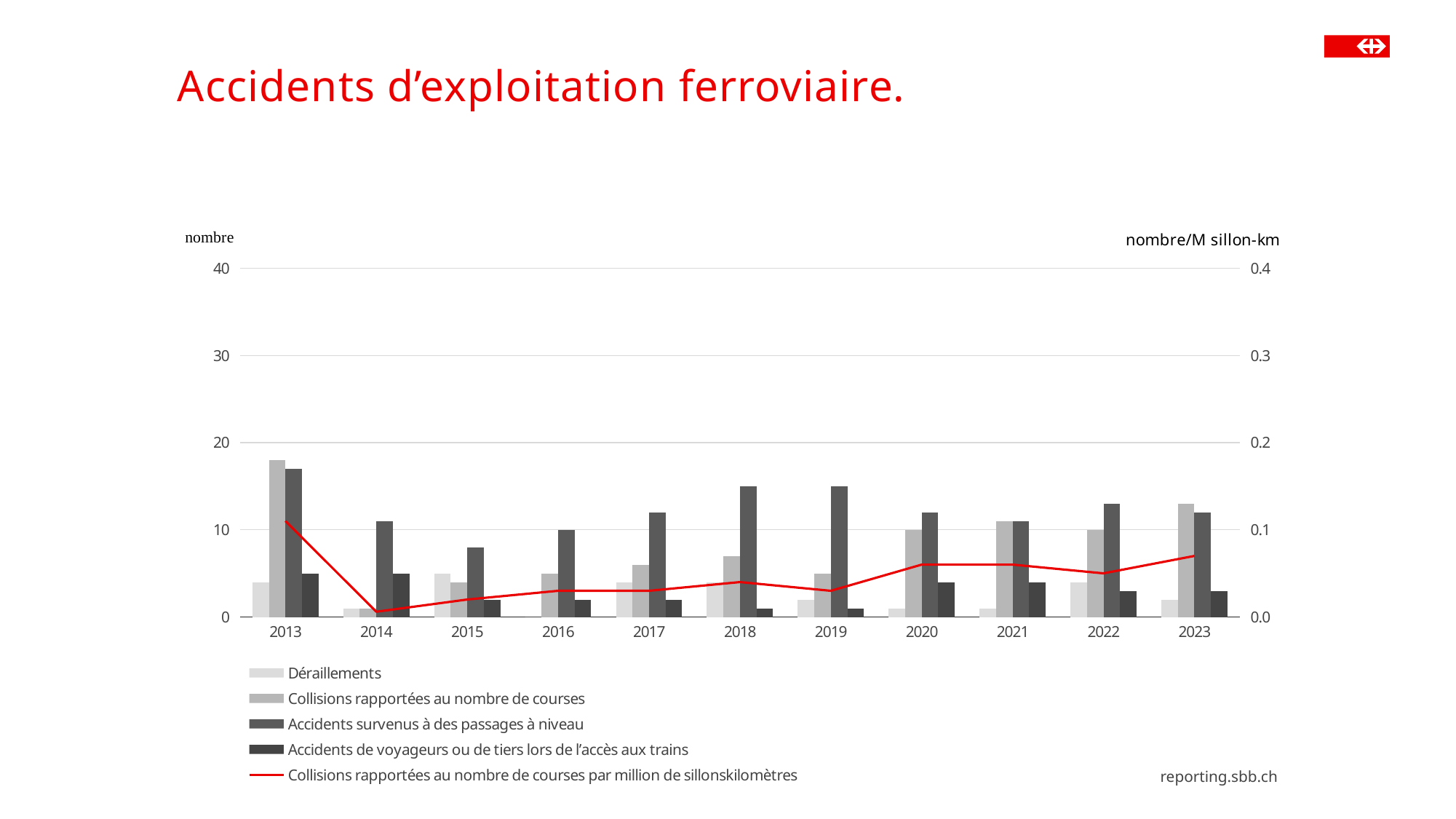
What kind of chart is shown on the slide? bar and line chart Is the value for Accidents survenus à des passages à niveau in 2018 greater or less than 10? greater In which year is the red line (Collisions rapportées au nombre de courses par million de sillonskilomètres) at its lowest? 2014 What is the label of the right-hand vertical axis? nombre/M sillon-km Is the value for Collisions rapportées au nombre de courses in 2013 greater or less than 10? greater Does the red line rise or fall between 2013 and 2014? fall How many years are shown on the x axis? 11 Which year has the larger value for Accidents survenus à des passages à niveau, 2013 or 2014? 2013 Is the value of the red line (Collisions rapportées au nombre de courses par million de sillonskilomètres) in 2020 greater or less than 0.1? less How many series does the legend list? 5 In which year is the bar for Collisions rapportées au nombre de courses the highest? 2013